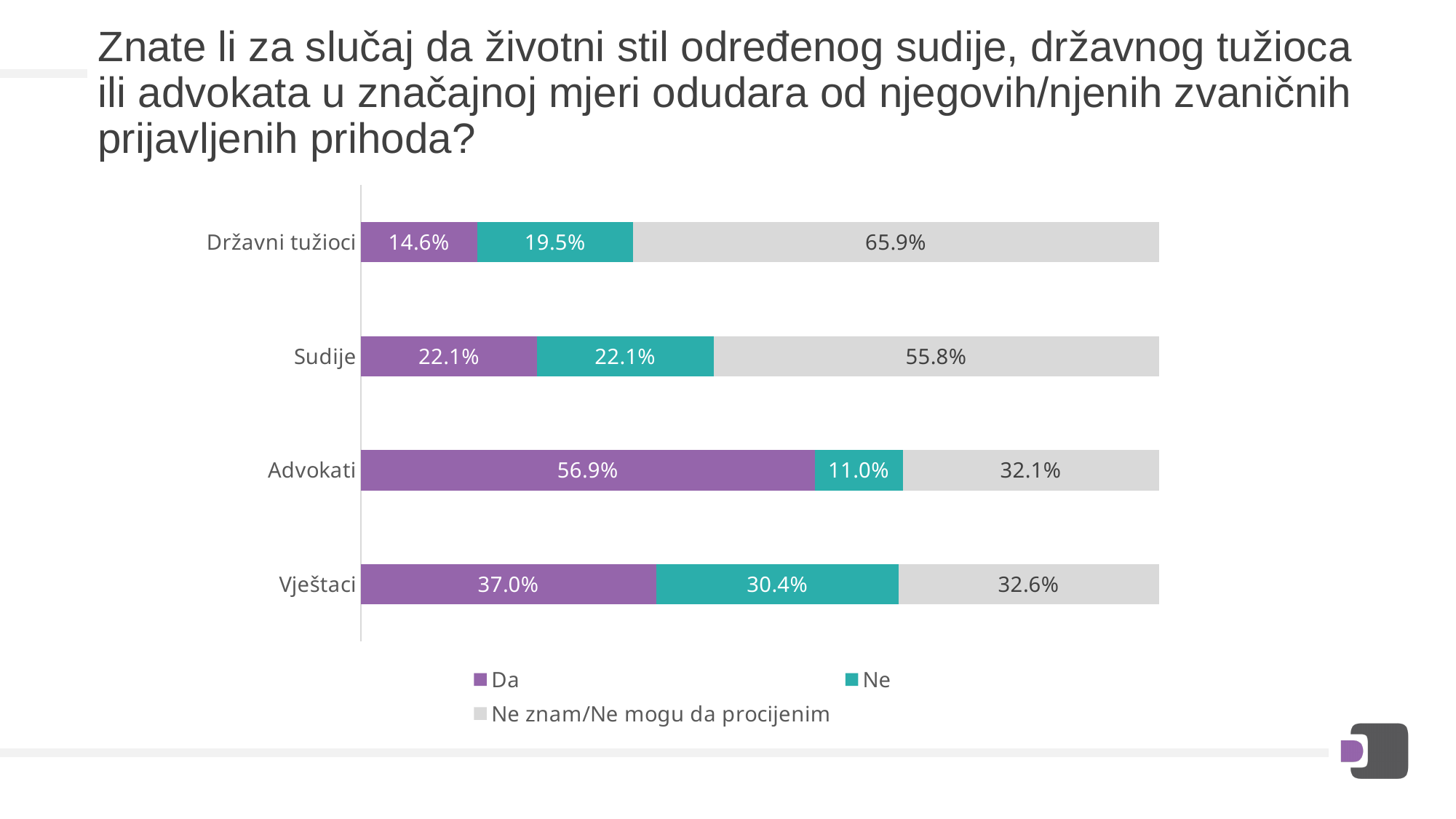
Which category has the lowest 'Da' value? Državni tužioci How many categories are shown on the chart? 4 Which series is shown in purple? Da What is the 'Ne' value for Vještaci? 30.4% Which category has the lowest 'Ne' value? Advokati What is the 'Da' value for Advokati? 56.9% How many series does the legend list? 3 What kind of chart is shown on the slide? Stacked bar chart What is the difference between the 'Da' values for Advokati and Vještaci? 19.9% Which is larger: the 'Ne znam/Ne mogu da procijenim' value for Sudije or for Vještaci? Sudije Which category has the highest 'Da' value? Advokati What is the 'Ne znam/Ne mogu da procijenim' value for Državni tužioci? 65.9%